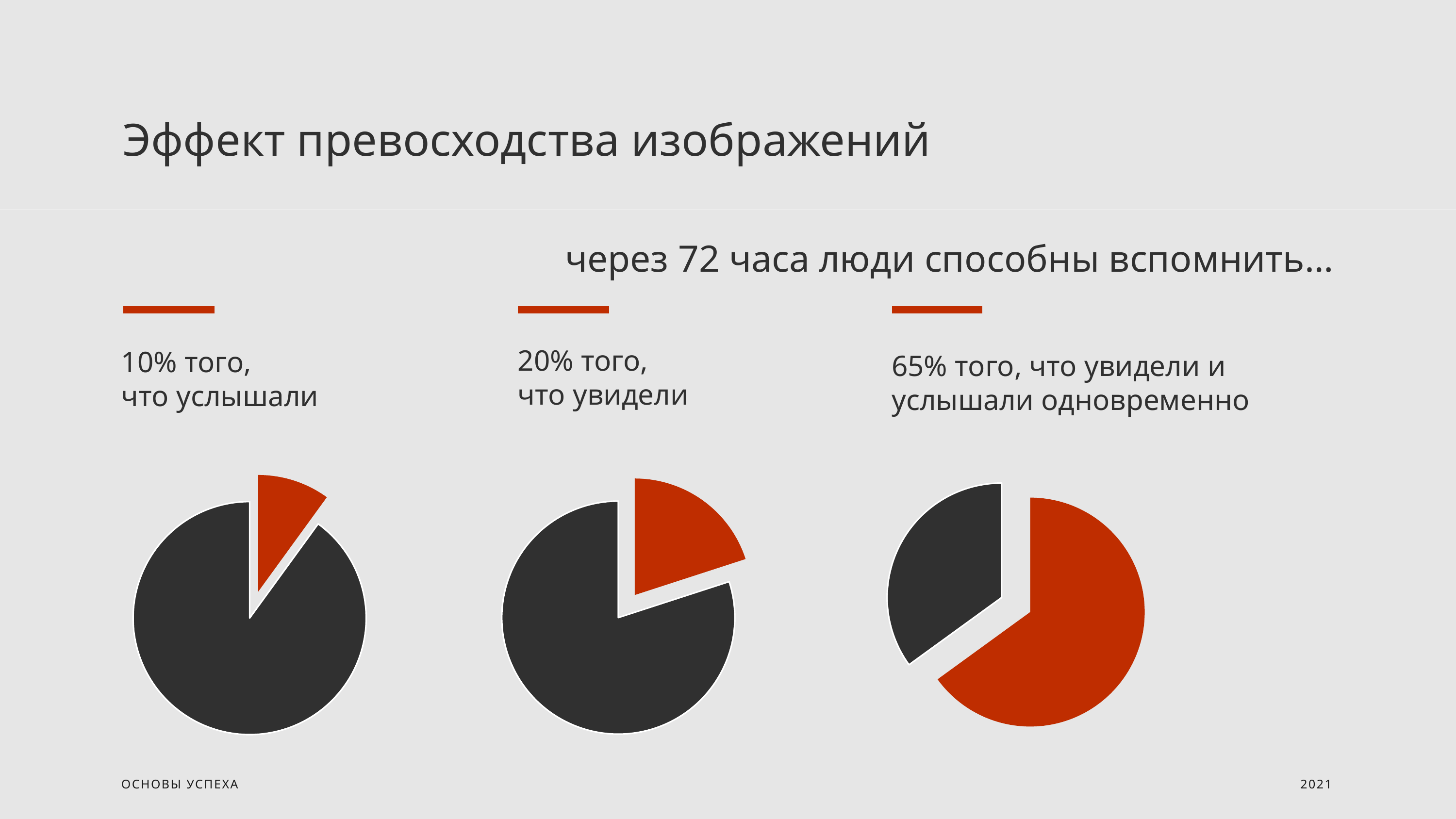
Which of the three pie charts shows the largest highlighted (red) share? 65% того, что увидели и услышали одновременно What is the difference between the share recalled for seen only (middle chart) and heard only (left chart)? 10% In the right pie chart, what share of what people saw and heard simultaneously can they recall after 72 hours? 65% Which of the three pie charts shows the smallest highlighted (red) share? 10% того, что услышали What colour is the highlighted (exploded) slice in each pie chart? red What kind of chart is used on this slide? pie chart How many pie charts are on the slide? 3 Which is larger: the red slice in the middle pie chart or the red slice in the left pie chart? the middle pie chart How many slices does each pie chart have? 2 In the middle pie chart, what share of what people saw can they recall after 72 hours? 20% In the left pie chart, what share of what people heard can they recall after 72 hours? 10% What is the difference between the share recalled for seen-and-heard (right chart) and the share recalled for seen only (middle chart)? 45%